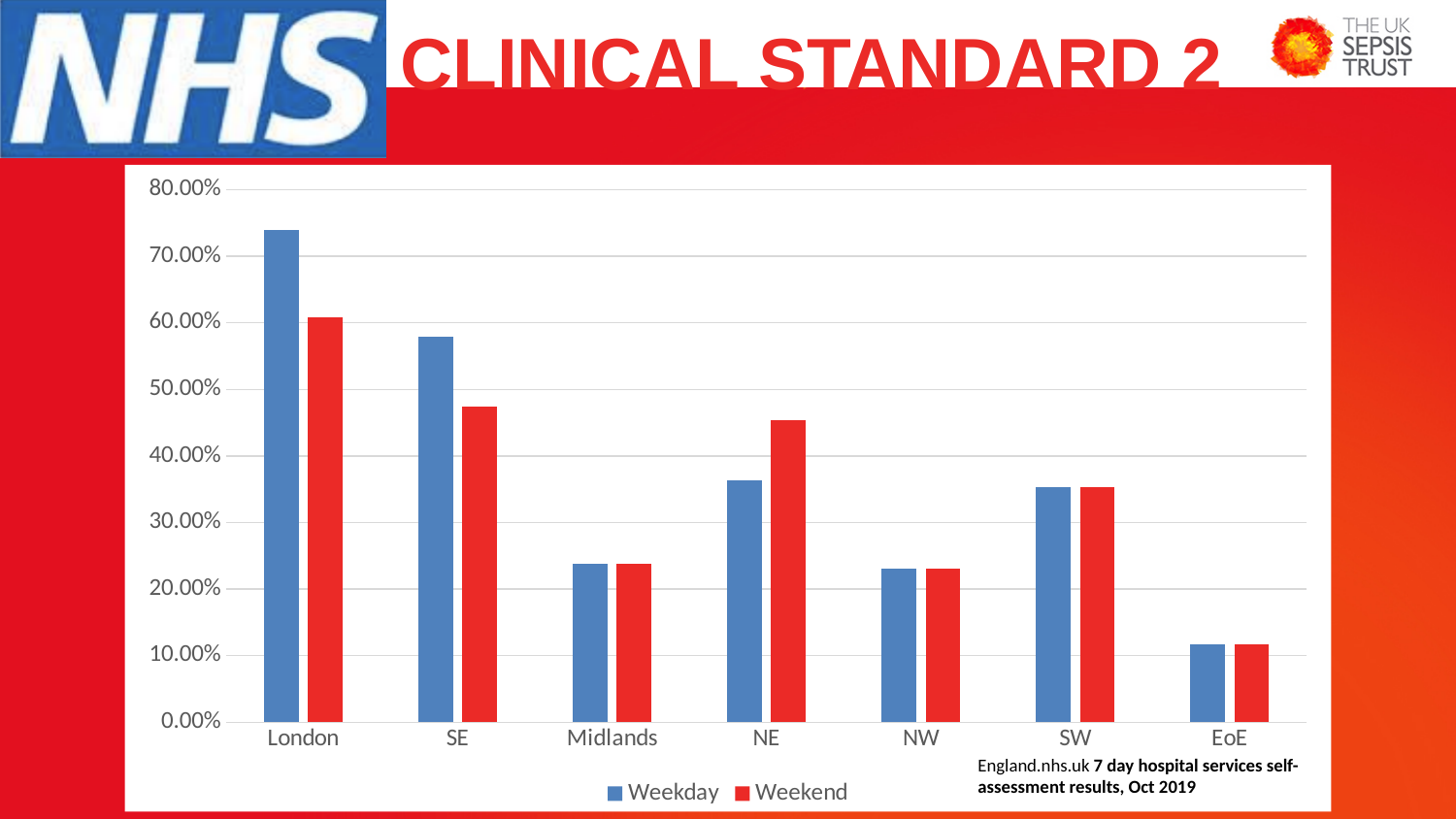
Is the Weekend value for SE greater or less than 50.00%? less How many regions are shown on the x axis? 7 What kind of chart is shown on the slide? bar chart Is the Weekday value for London greater or less than 70.00%? greater For London, which is larger: the Weekday value or the Weekend value? Weekday What are the two entries in the chart legend? Weekday and Weekend How many series does the legend list? 2 For NE, which is larger: the Weekday value or the Weekend value? Weekend Which region has the highest Weekday value? London Which region has the lowest Weekday value? EoE Which region has the lowest Weekend value? EoE Is the Weekend value for NE greater or less than 40.00%? greater